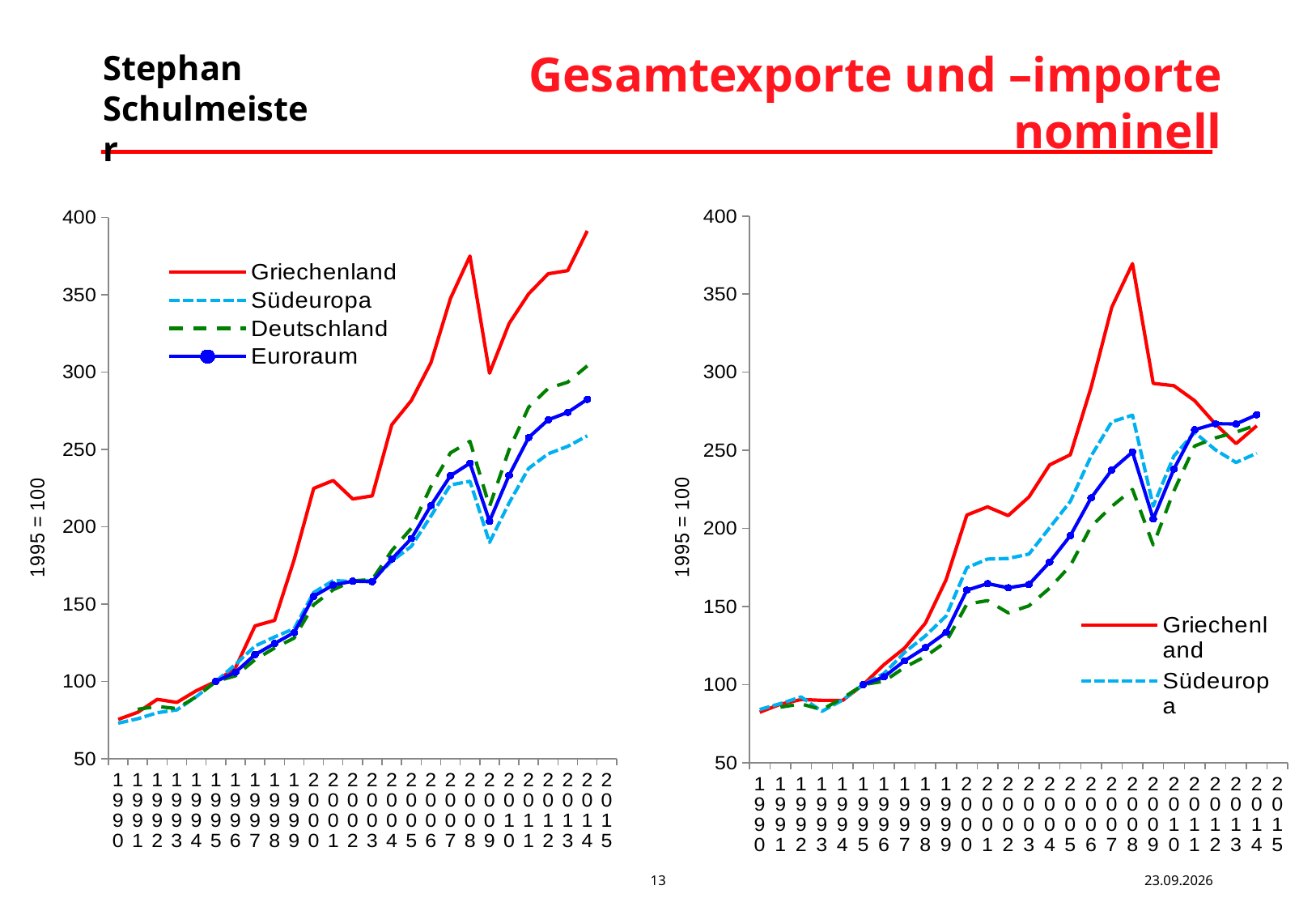
What kind of chart is the left chart on the slide? line chart In the left chart, which is higher in 2014: Deutschland or Südeuropa? Deutschland How many series does the legend of the left chart list? 4 In the left chart, which series has the highest value in 2014? Griechenland In the left chart, does the Griechenland series overall rise or fall from 1990 to 2014? rise In the left chart, is the value for Griechenland in 2014 greater or less than 350? greater What is the y-axis label of the left chart? 1995 = 100 How many series does the legend of the right chart list? 2 In the right chart, is the value for Griechenland in 2008 greater or less than 350? greater In the right chart, is the value for Griechenland in 2010 greater or less than 300? less In the right chart, which is higher in 2008: Griechenland or Euroraum? Griechenland